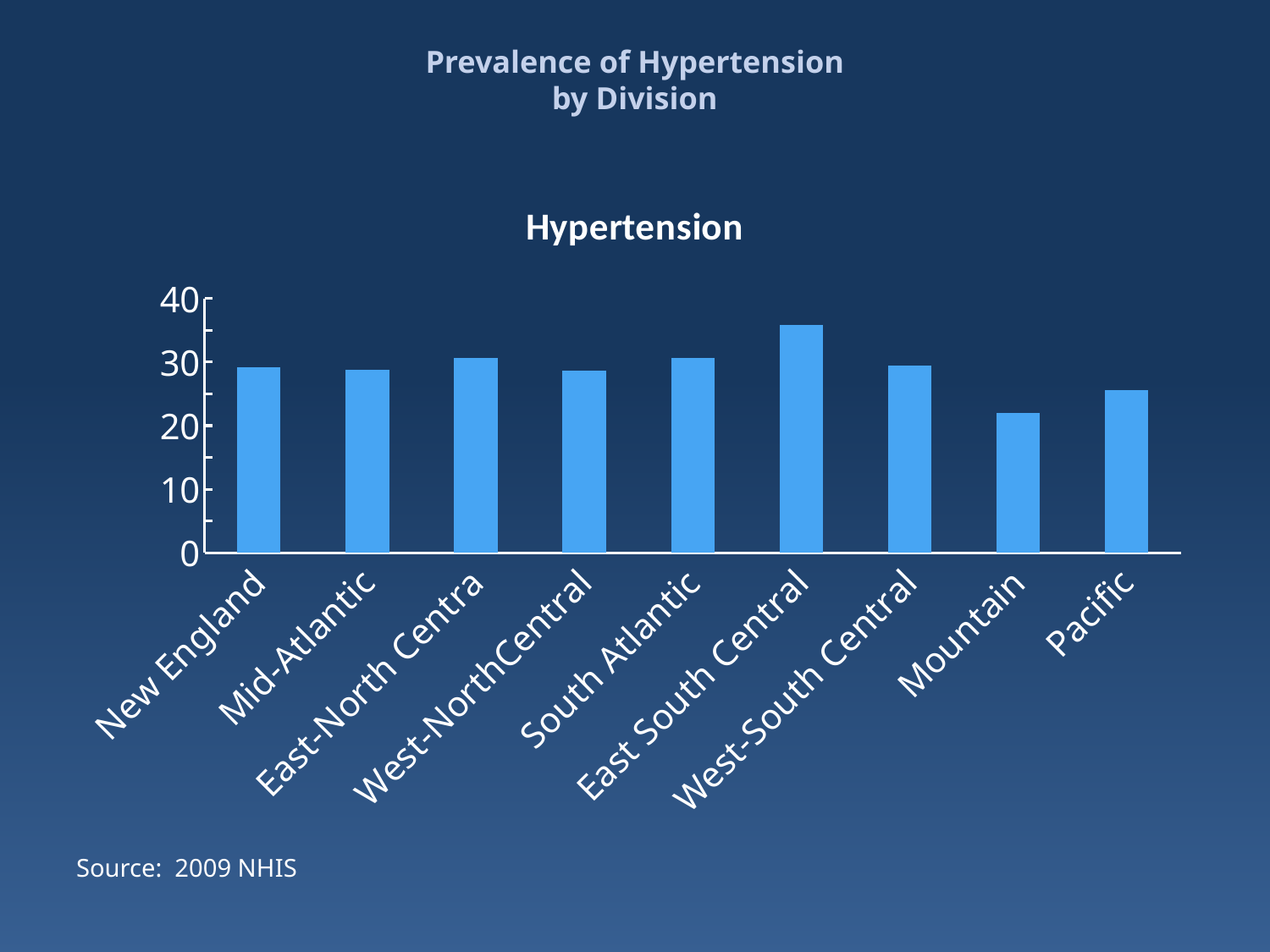
How many divisions are plotted on the chart? 9 What source is cited for the chart data? 2009 NHIS What kind of chart is shown on the slide? bar chart Is the value for East South Central greater or less than 30? greater Is the value for Mountain greater or less than 20? greater Which is larger, the value for East South Central or the value for Mountain? East South Central Which division has the highest prevalence of hypertension? East South Central Which is larger, the value for Pacific or the value for Mountain? Pacific Is the value for Pacific greater or less than 30? less What is the title shown directly above the chart? Hypertension Which division has the lowest prevalence of hypertension? Mountain